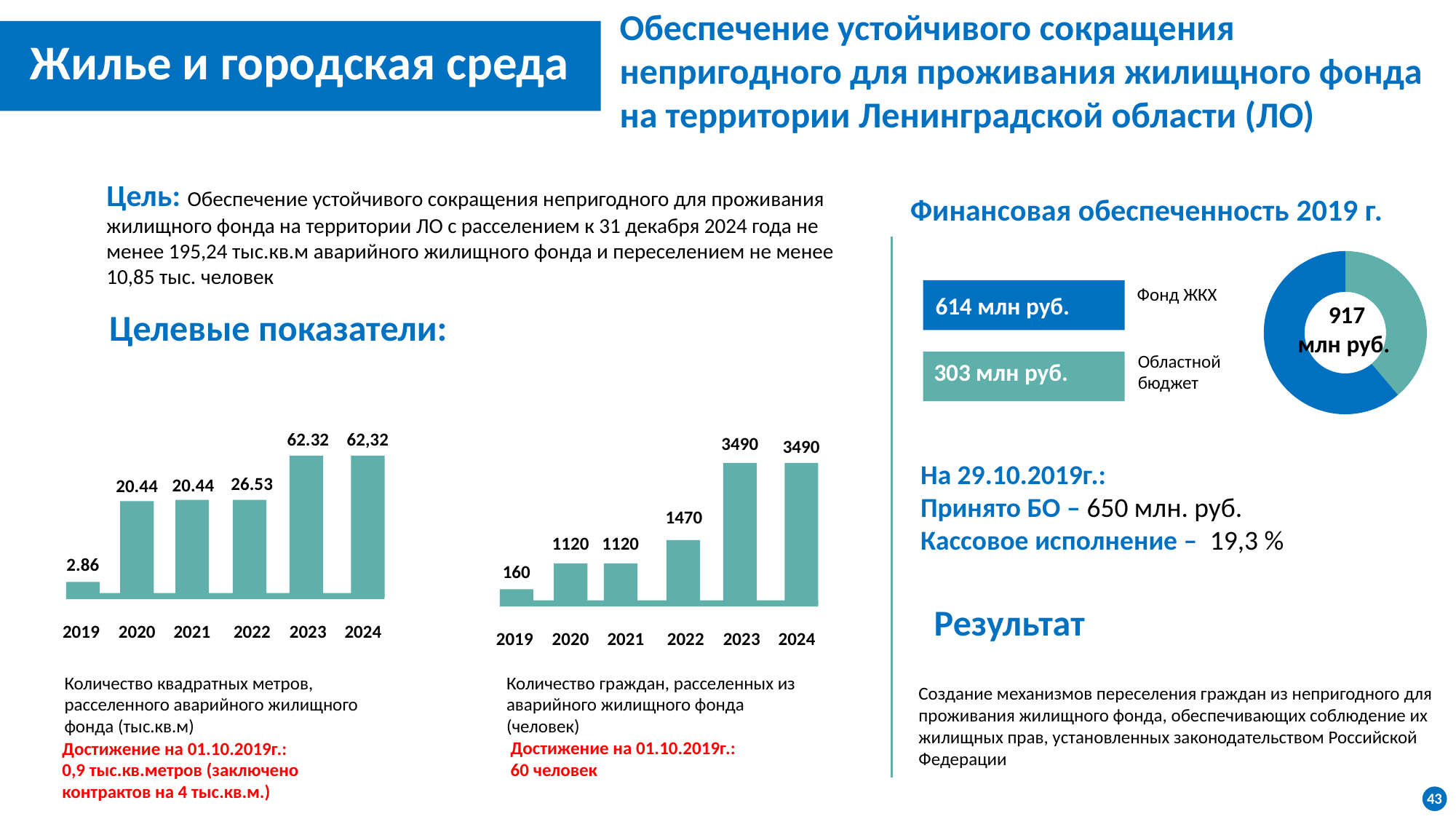
In the middle bar chart (Количество граждан), what is the value for 2019? 160 How many years are shown on the x axis of the left bar chart (Количество квадратных метров)? 6 In the middle bar chart (Количество граждан), which is larger, the value for 2021 or the value for 2022? 2022 In the middle bar chart (Количество граждан), what is the difference between the 2024 value and the 2019 value? 3330 In the left bar chart (Количество квадратных метров, расселенного аварийного жилищного фонда), what is the value for 2022? 26.53 In the left bar chart (Количество квадратных метров), what is the value for 2019? 2.86 In the middle bar chart (Количество граждан), do the values rise or fall from 2019 to 2024? rise In the left bar chart (Количество квадратных метров), which year has the lowest value? 2019 In the Финансовая обеспеченность 2019 г. chart, what is the value for Фонд ЖКХ? 614 млн руб. In the middle bar chart (Количество граждан, расселенных из аварийного жилищного фонда), what is the value for 2022? 1470 What kind of chart is used for Финансовая обеспеченность 2019 г.? donut (pie) chart In the left bar chart (Количество квадратных метров), what is the difference between the 2023 value and the 2022 value? 35.79